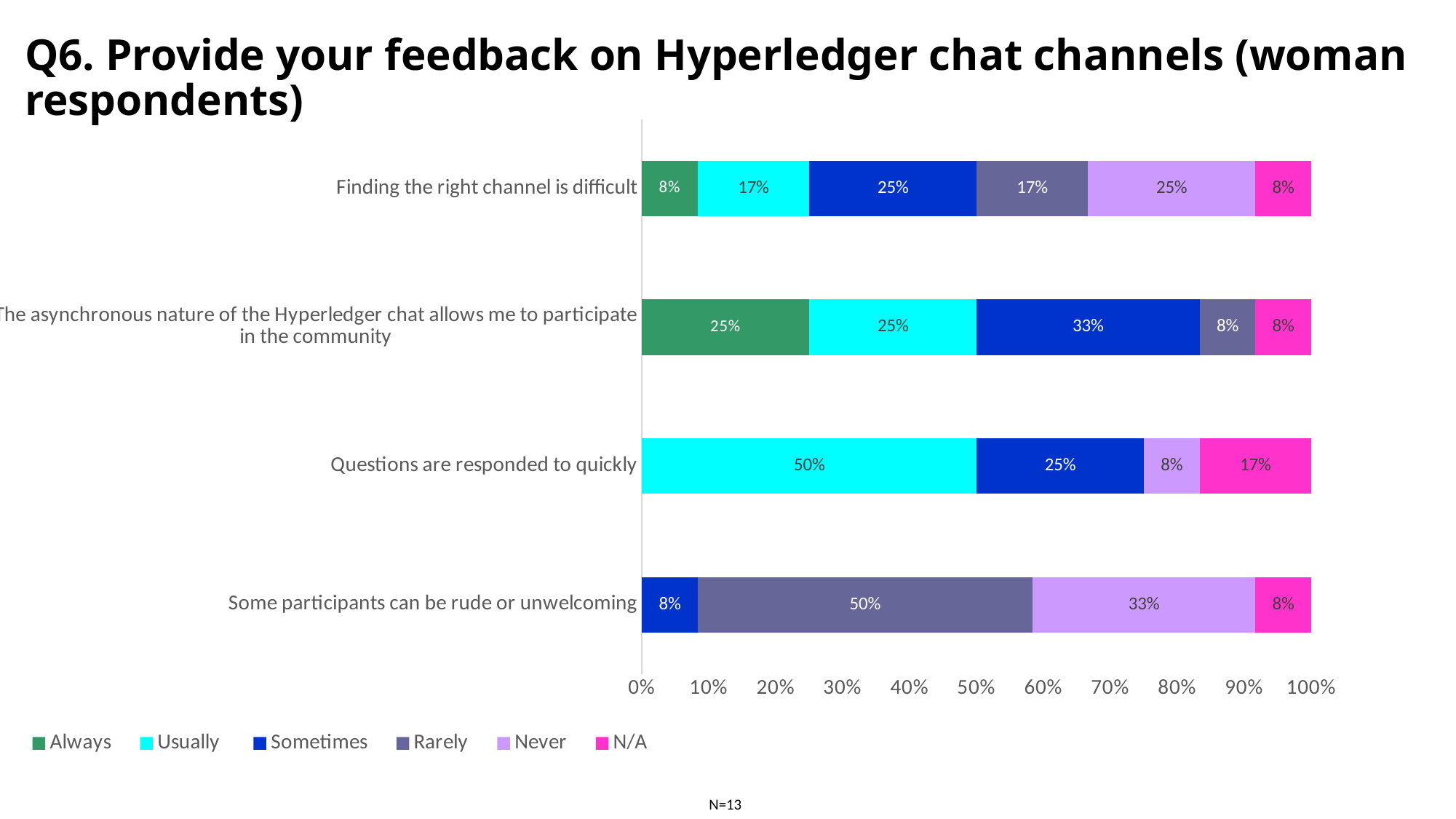
What is the 'Sometimes' value for 'The asynchronous nature of the Hyperledger chat allows me to participate in the community'? 33% What kind of chart is shown on the slide? Stacked bar chart Which statement has the highest 'Never' value? Some participants can be rude or unwelcoming How many series does the legend list? 6 Which statement has the highest 'Always' value? The asynchronous nature of the Hyperledger chat allows me to participate in the community What is the 'Never' value for 'Finding the right channel is difficult'? 25% What is the sample size noted at the bottom of the slide? N=13 How many statements (categories) are plotted in the chart? 4 What is the difference between the 'Never' value and the 'N/A' value for 'Some participants can be rude or unwelcoming'? 25% Which is larger for 'Questions are responded to quickly': the 'Sometimes' value or the 'N/A' value? Sometimes What is the 'Rarely' value for 'Some participants can be rude or unwelcoming'? 50% What is the 'Usually' value for 'Questions are responded to quickly'? 50%